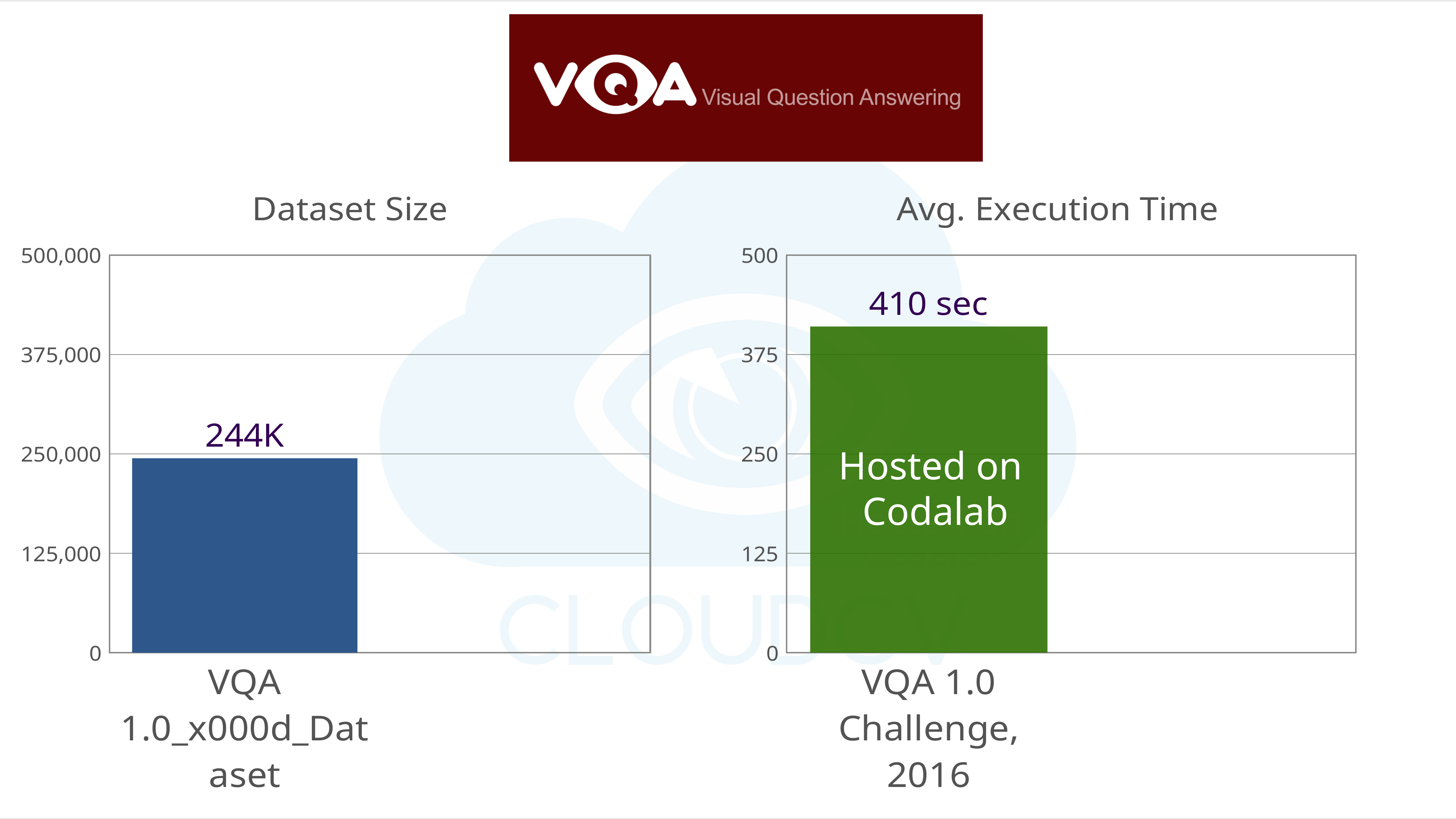
In the Avg. Execution Time chart, what text is written on the green bar? Hosted on Codalab In the Avg. Execution Time chart, is the value for VQA 1.0 Challenge, 2016 greater or less than 500? less What kind of chart is the Avg. Execution Time chart? bar chart In the Dataset Size chart, what value is labelled on the bar? 244K In the Avg. Execution Time chart, what is the value for VQA 1.0 Challenge, 2016? 410 sec In the Avg. Execution Time chart, is the value for VQA 1.0 Challenge, 2016 greater or less than 375? greater What is the title of the chart on the right side of the slide? Avg. Execution Time In the Dataset Size chart, is the value of the bar greater or less than 250,000? less What kind of chart is the Dataset Size chart? bar chart How many bars does the Avg. Execution Time chart show? 1 How many bars does the Dataset Size chart show? 1